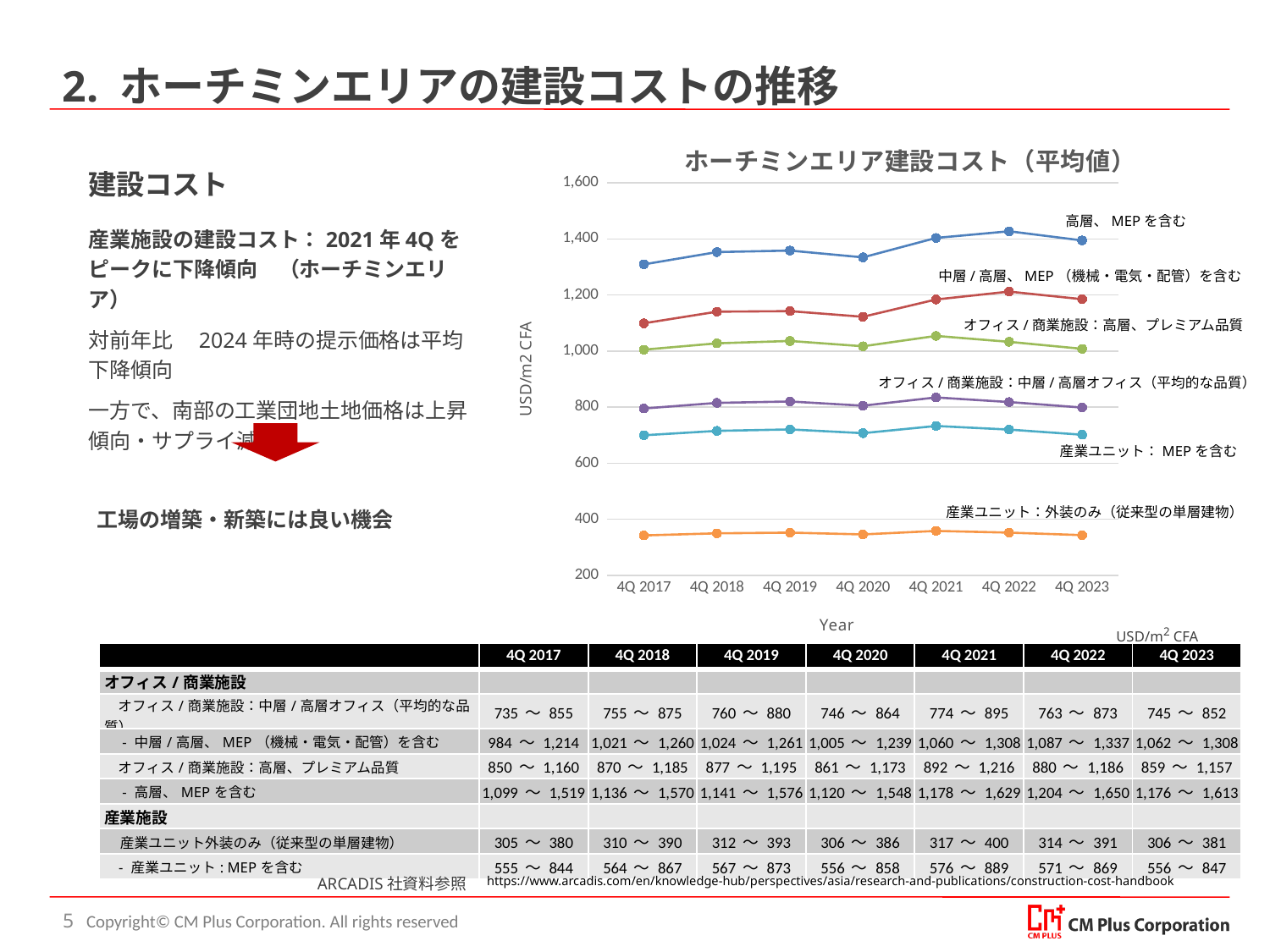
What is the label on the vertical axis of the chart? USD/m2 CFA What kind of chart is shown on the slide? Line chart Is the value for 産業ユニット：MEP を含む at 4Q 2019 greater or less than 800? less Is the value for 産業ユニット：外装のみ（従来型の単層建物） at 4Q 2021 greater or less than 400? less Which series has the highest values in the chart? 高層、MEP を含む How many data series are plotted in the chart? 6 Does the 高層、MEP を含む series rise or fall from 4Q 2022 to 4Q 2023? fall Is the value for 高層、MEP を含む at 4Q 2017 greater or less than 1,200? greater Which series has the lowest values in the chart? 産業ユニット：外装のみ（従来型の単層建物） In which year does the 高層、MEP を含む series reach its highest value? 4Q 2022 How many time points are plotted along the x axis of the chart? 7 What is the title of the chart? ホーチミンエリア建設コスト（平均値）